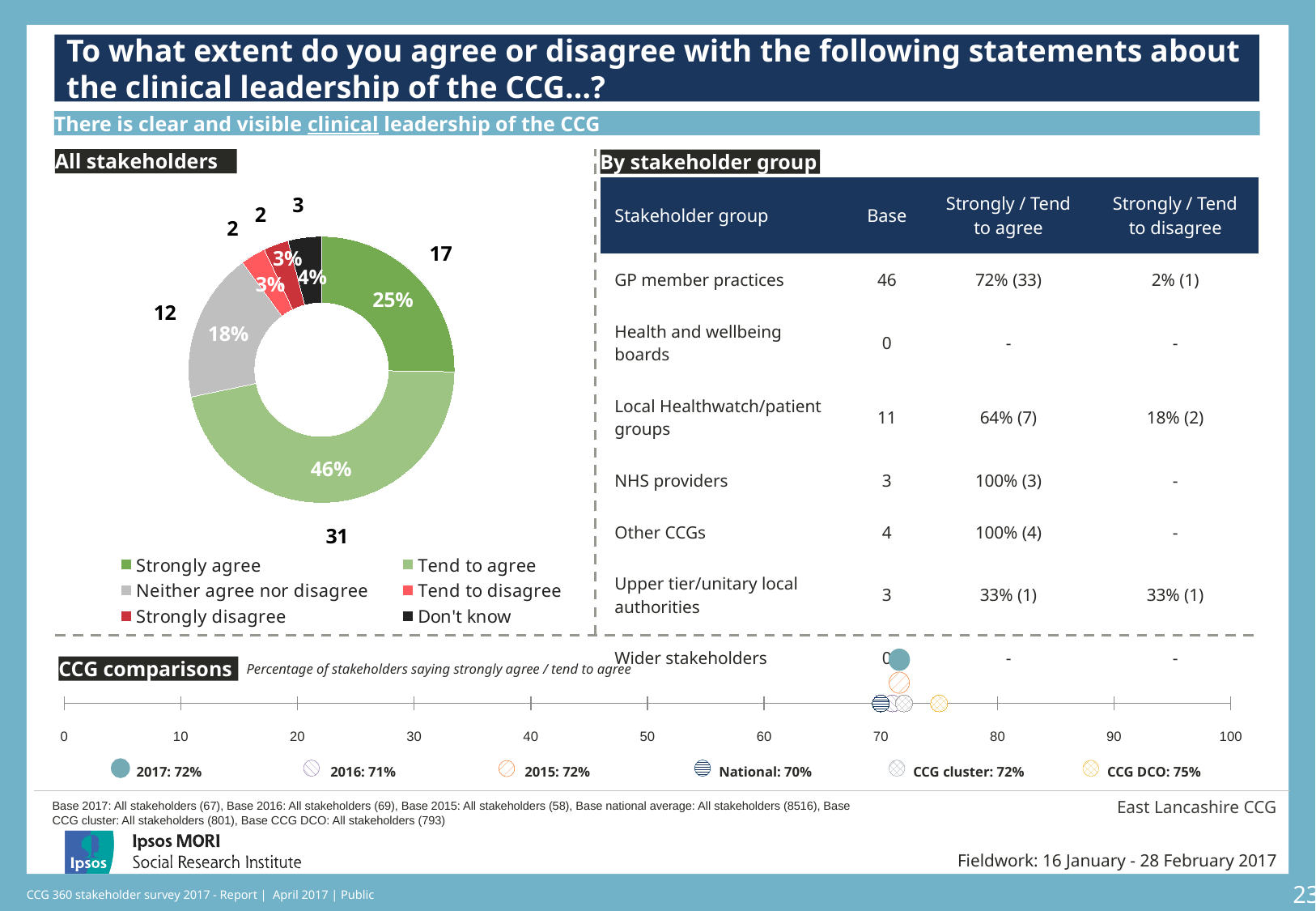
In the 'All stakeholders' chart, which response has the largest share? Tend to agree In the 'All stakeholders' chart, how many percentage points larger is 'Tend to agree' than 'Strongly agree'? 21 percentage points In the 'All stakeholders' chart, how many response categories does the legend list? 6 In the 'All stakeholders' chart, what percentage of stakeholders said 'Tend to agree'? 46% In the 'All stakeholders' chart, what colour represents 'Don't know'? black In the 'All stakeholders' chart, how many stakeholders said 'Neither agree nor disagree'? 12 What kind of chart is shown under 'All stakeholders'? pie chart (donut) In the 'All stakeholders' chart, which is larger: 'Neither agree nor disagree' or 'Don't know'? Neither agree nor disagree In the 'All stakeholders' chart, what percentage of stakeholders said 'Strongly agree'? 25% In the 'CCG comparisons' chart, which comparator has the lowest percentage? National: 70% In the 'CCG comparisons' chart, which comparator has the highest percentage? CCG DCO: 75% In the 'CCG comparisons' chart, what is the 2017 percentage of stakeholders saying strongly agree / tend to agree? 72%